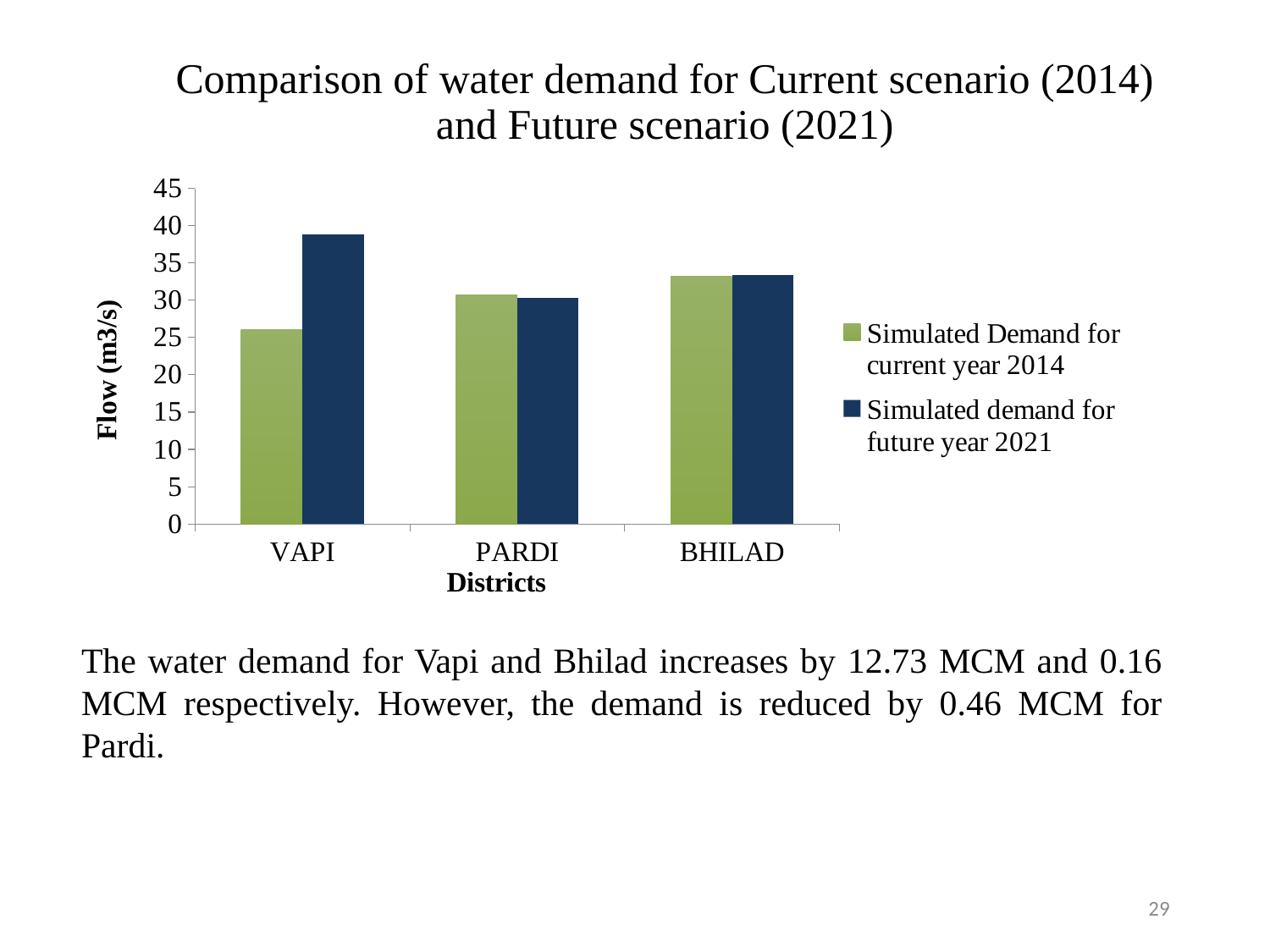
How many series does the chart's legend list? 2 Is the simulated demand for future year 2021 for BHILAD greater or less than 30? greater Which is larger: the simulated demand for future year 2021 for VAPI or for BHILAD? VAPI Is the simulated demand for future year 2021 for VAPI greater or less than 35? greater Which district has the lowest simulated demand for future year 2021? PARDI Which district has the highest simulated demand for future year 2021? VAPI How many districts are shown on the x axis of the chart? 3 What is the label of the y axis of the chart? Flow (m3/s) For VAPI, which is larger: the simulated demand for current year 2014 or for future year 2021? Simulated demand for future year 2021 What kind of chart is shown on the slide? bar chart Which district has the lowest simulated demand for current year 2014? VAPI Is the simulated demand for current year 2014 for VAPI greater or less than 30? less